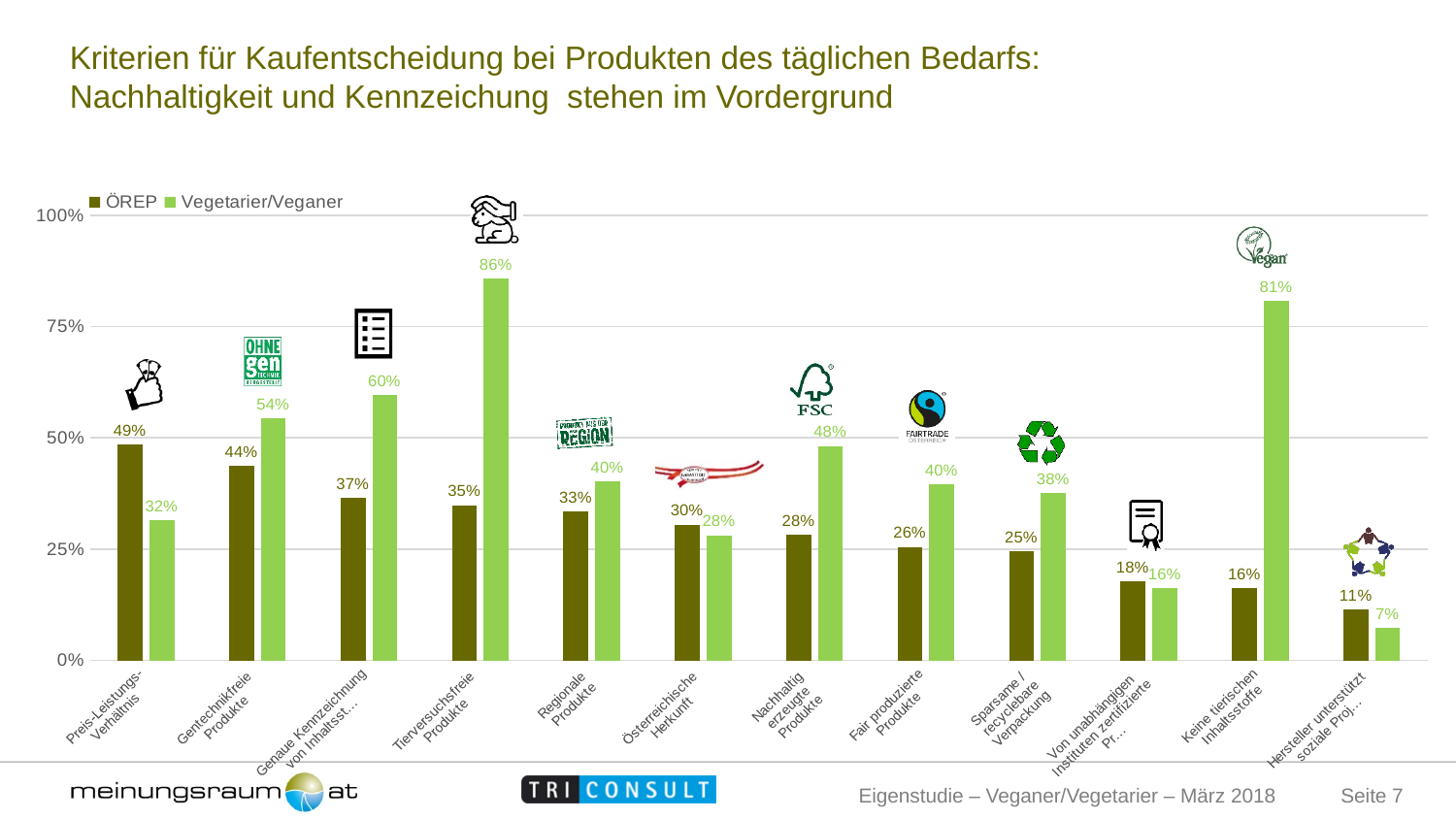
What kind of chart is shown on the slide? Bar chart What is the Vegetarier/Veganer value for Tierversuchsfreie Produkte? 86% How many series does the legend list? 2 How many categories are shown on the x axis? 12 Which category has the lowest Vegetarier/Veganer value? Hersteller unterstützt soziale Proj... For Österreichische Herkunft, which series has the larger value, ÖREP or Vegetarier/Veganer? ÖREP Do the ÖREP values rise or fall from left to right along the x axis? Fall What is the Vegetarier/Veganer value for Keine tierischen Inhaltsstoffe? 81% What is the ÖREP value for Preis-Leistungs-Verhältnis? 49% Which category has the highest ÖREP value? Preis-Leistungs-Verhältnis What is the difference between the Vegetarier/Veganer and ÖREP values for Tierversuchsfreie Produkte? 51% What are the two series named in the legend? ÖREP and Vegetarier/Veganer